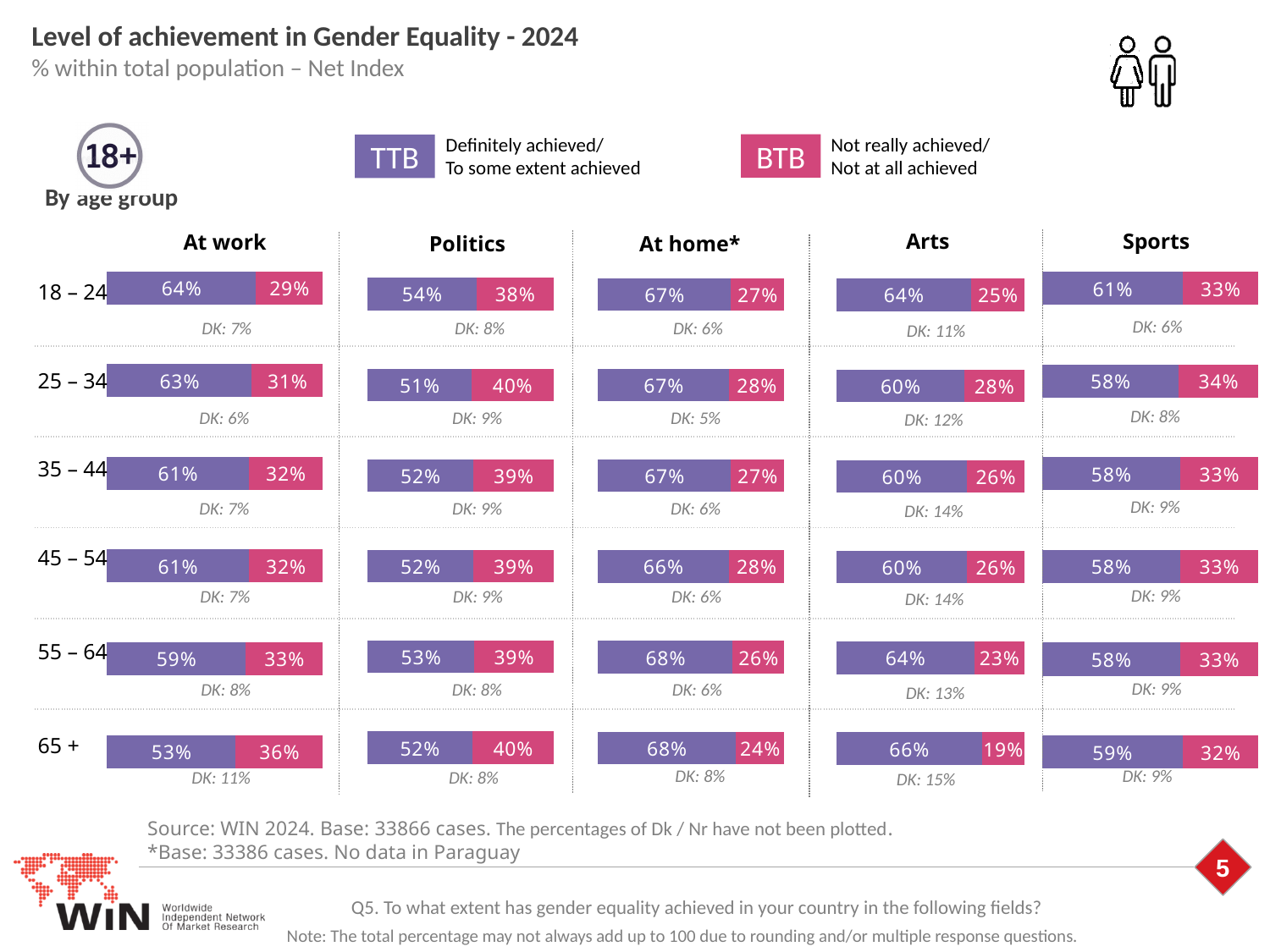
In the 'Politics' chart, what is the BTB value for the 25 – 34 age group? 40% In the 'Arts' chart, which age group has the highest TTB value? 65 + In the 'At work' chart, which age group has the lowest TTB value? 65 + In the 'At work' chart, does the TTB value rise or fall as the age group gets older? fall In the 'Arts' chart, what is the BTB value for the 65 + age group? 19% In the 'At home*' chart, what is the combined TTB and BTB total for the 55 – 64 age group? 94% How many age groups are shown in each chart? 6 In the 'At work' chart, what is the difference between the TTB and BTB values for the 65 + age group? 17% What type of chart is used to show the results for each field? Stacked bar chart In the 'At work' chart, what is the TTB value for the 18 – 24 age group? 64% What does the BTB label in the legend stand for? Not really achieved/ Not at all achieved In the 'Sports' chart, is the TTB value for the 18 – 24 age group larger or smaller than the TTB value for the 25 – 34 age group? larger